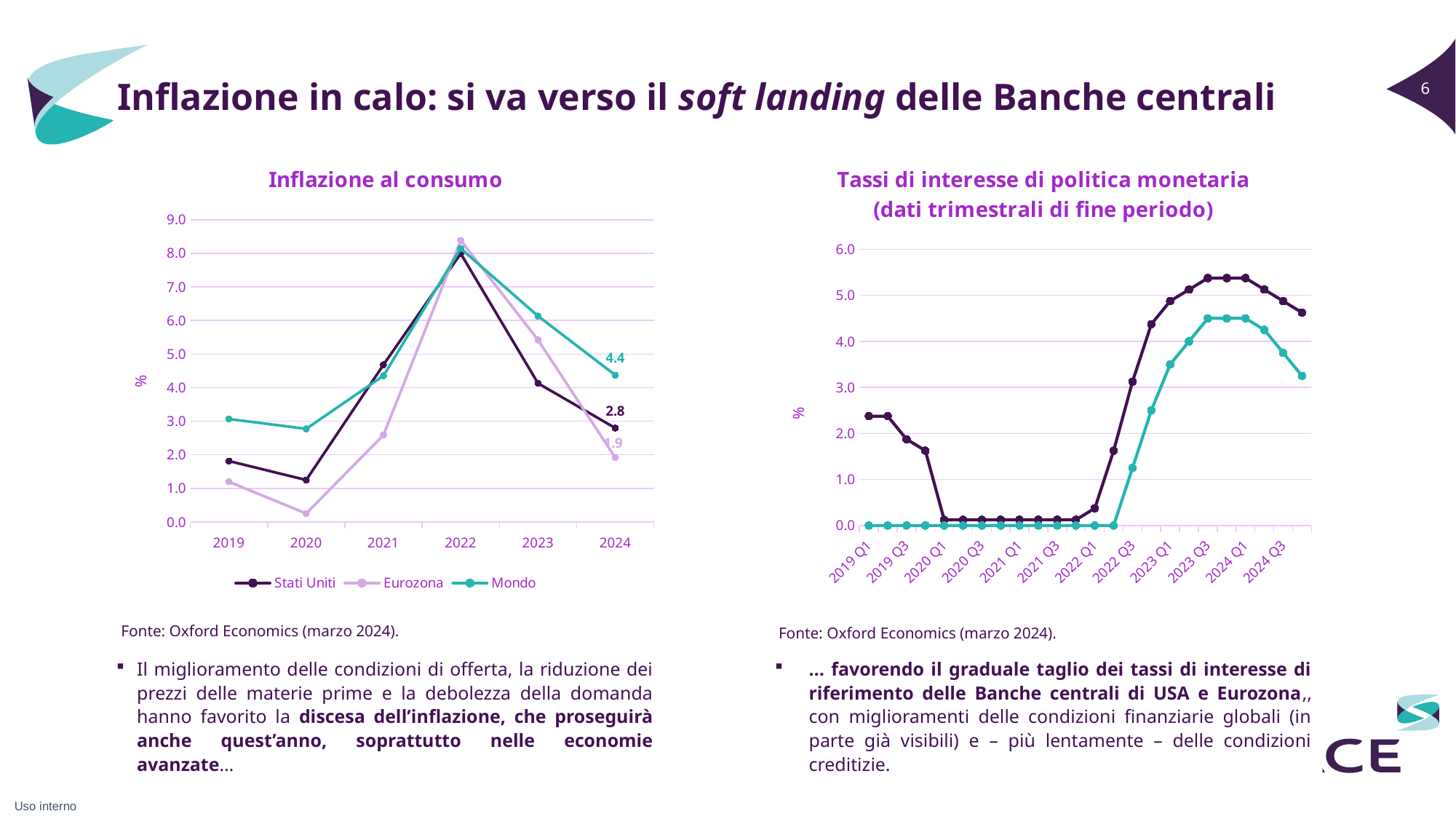
In the 'Inflazione al consumo' chart, how many years are shown on the x axis? 6 In the 'Inflazione al consumo' chart, how many series does the legend list? 3 In the 'Tassi di interesse di politica monetaria' chart, is the highest value of the upper (dark) line greater or less than 5.0? greater In the 'Inflazione al consumo' chart, what is the value for Mondo in 2024? 4.4 In the 'Inflazione al consumo' chart, what is the value for Eurozona in 2024? 1.9 In the 'Inflazione al consumo' chart, which is larger in 2024: Stati Uniti or Eurozona? Stati Uniti What kind of chart is the right chart titled 'Tassi di interesse di politica monetaria'? line chart In the 'Inflazione al consumo' chart, what is the difference between the 2024 values for Mondo and Stati Uniti? 1.6 In the 'Inflazione al consumo' chart, in which year does Stati Uniti reach its highest value? 2022 In the 'Inflazione al consumo' chart, is the value for Eurozona in 2020 greater or less than 1.0? less What kind of chart is the left chart titled 'Inflazione al consumo'? line chart In the 'Inflazione al consumo' chart, what is the value for Stati Uniti in 2024? 2.8